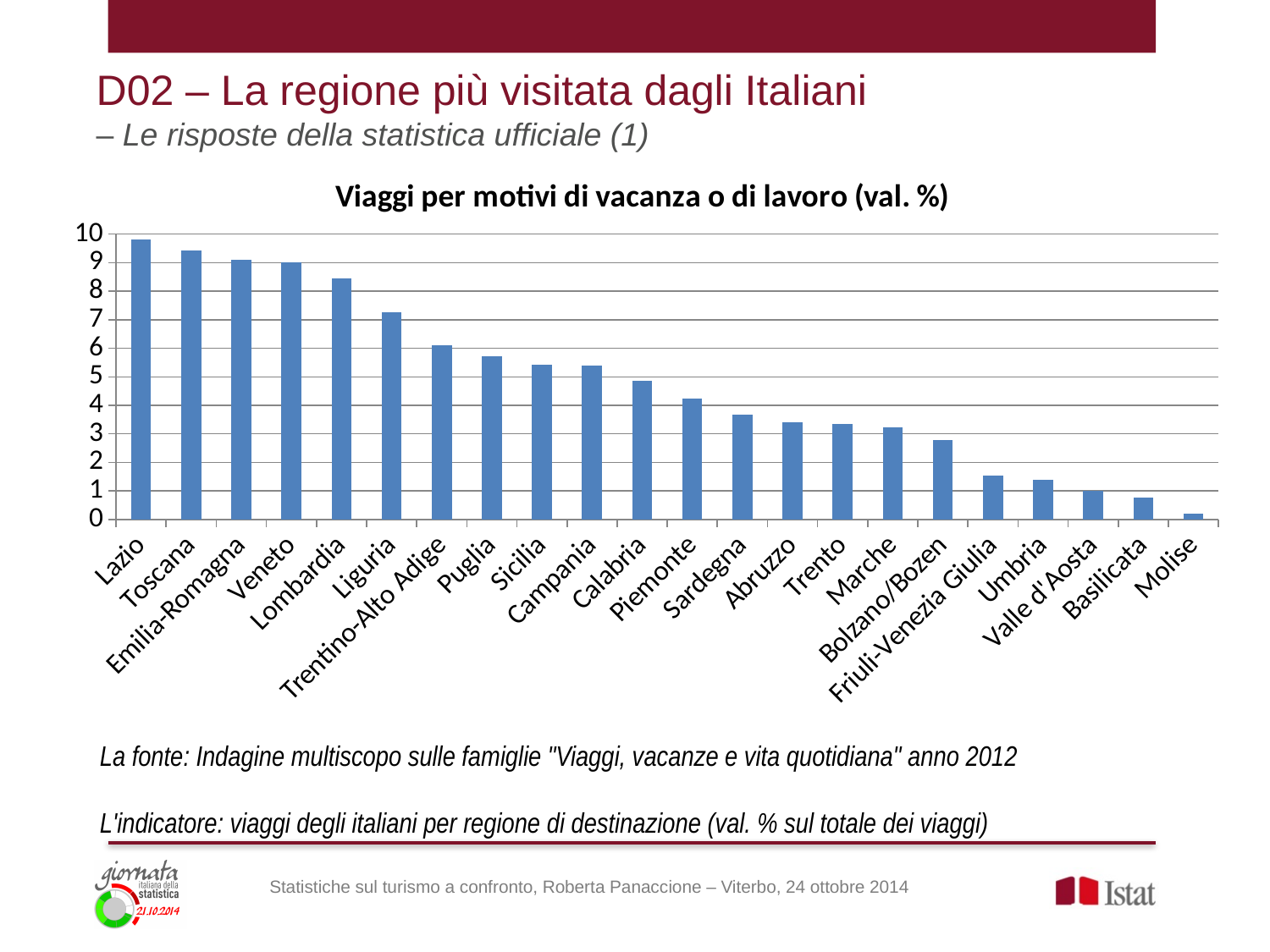
Which has a larger value, Liguria or Puglia? Liguria Is the value for Lazio greater or less than 9? greater How many regions are shown on the x axis of the chart? 22 Which region has the lowest value in the chart? Molise What type of chart is shown on the slide? bar chart Do the values rise or fall moving from left to right along the x axis? fall Is the value for Molise greater or less than 1? less What is the title of the chart? Viaggi per motivi di vacanza o di lavoro (val. %) Which has a larger value, Sardegna or Umbria? Sardegna Is the value for Lombardia greater or less than 8? greater Which region has the highest value in the chart? Lazio